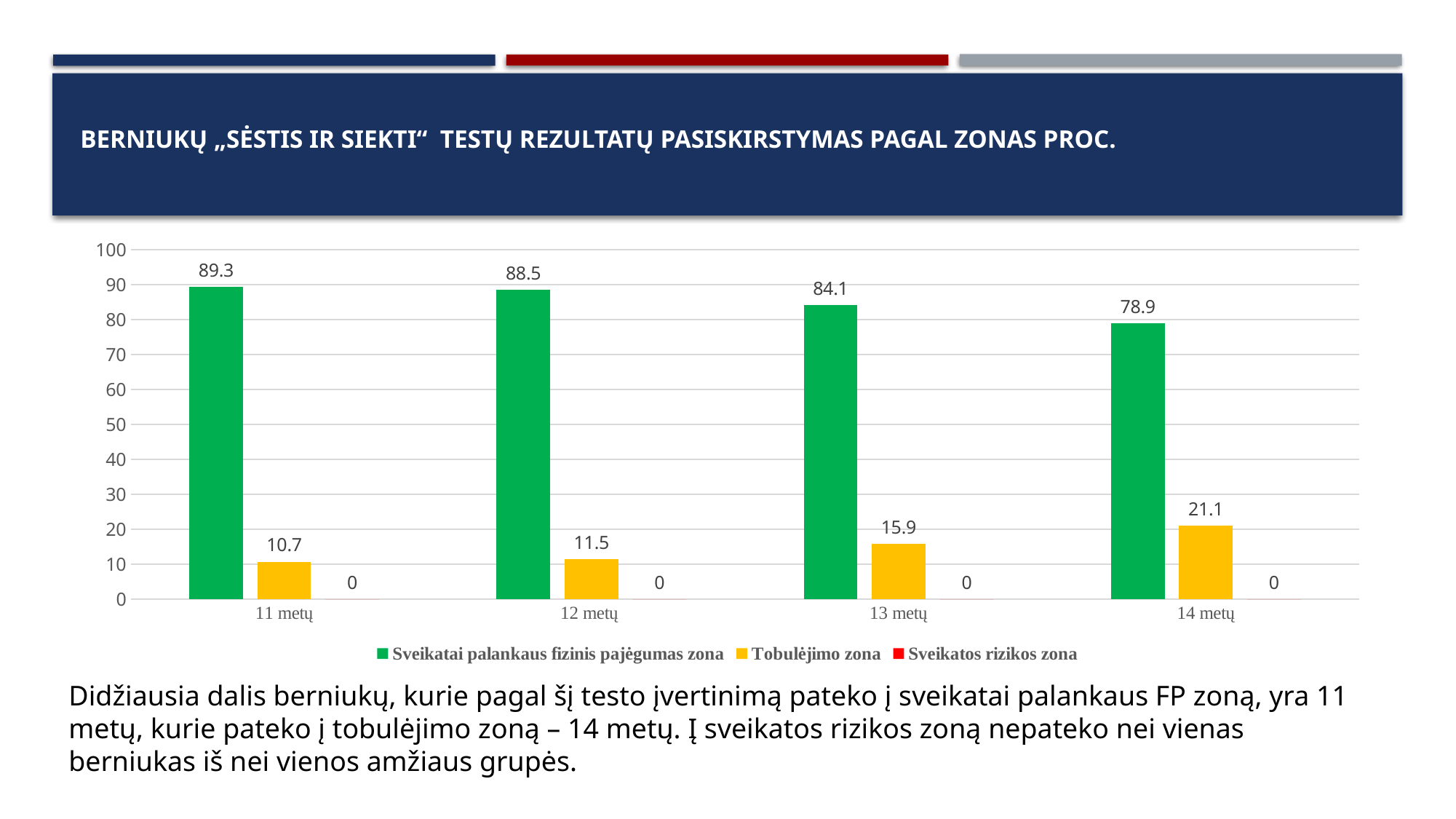
Which is larger: the 'Tobulėjimo zona' value for 12 metų or for 13 metų? 13 metų What is the difference between the 'Sveikatai palankaus fizinis pajėgumas zona' values for 11 metų and 14 metų? 10.4 What is the value for 'Tobulėjimo zona' for 14 metų? 21.1 Is the 'Sveikatai palankaus fizinis pajėgumas zona' value for 14 metų greater or less than 80? less What kind of chart is shown on the slide? bar chart Which age group has the highest value for 'Sveikatai palankaus fizinis pajėgumas zona'? 11 metų What is the value for 'Sveikatos rizikos zona' for 13 metų? 0 What is the value for 'Sveikatai palankaus fizinis pajėgumas zona' for 11 metų? 89.3 Which age group has the lowest value for 'Tobulėjimo zona'? 11 metų Do the 'Tobulėjimo zona' values rise or fall from 11 metų to 14 metų? rise How many age groups are shown on the x axis? 4 How many series does the legend list? 3